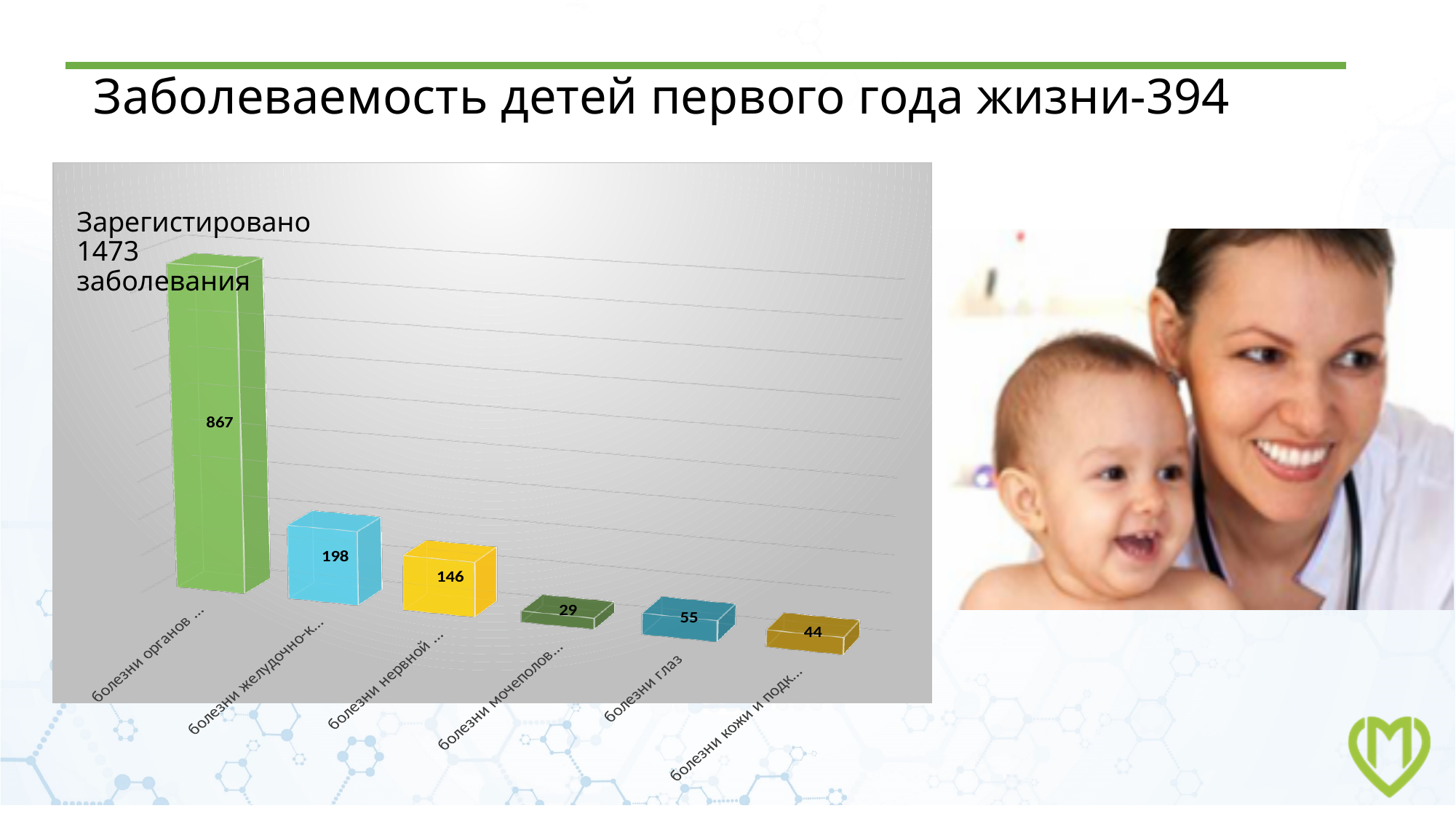
Which is larger: the value for "болезни желудочно-к..." or the value for "болезни нервной ..."? болезни желудочно-к... How many categories (bars) does the chart show? 6 What type of chart is shown on the slide? bar chart What is the value of the third bar, labelled "болезни нервной ..."? 146 Which category has the lowest value? болезни мочеполов... What is the value of the last bar, labelled "болезни кожи и подк..."? 44 According to the text inside the chart area, how many diseases were registered in total? 1473 What is the value for the category "болезни глаз"? 55 What is the value of the first bar, labelled "болезни органов ..."? 867 What is the value of the second bar, labelled "болезни желудочно-к..."? 198 What is the difference between the values for "болезни глаз" and "болезни кожи и подк..."? 11 Which category has the highest value? болезни органов ...